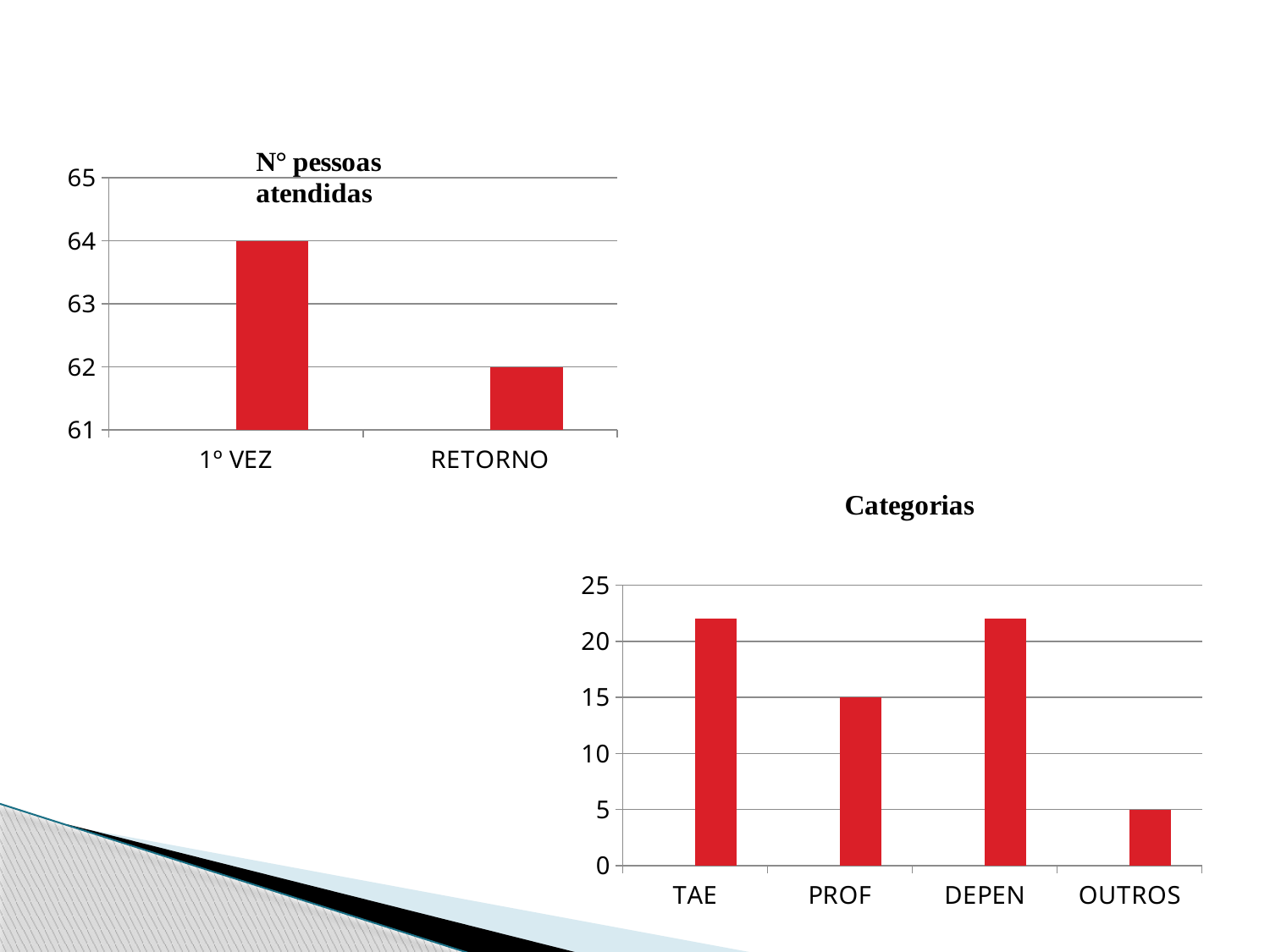
In the 'Categorias' chart, which category has the lowest value? OUTROS In the 'Categorias' chart, which is larger, the value for DEPEN or the value for PROF? DEPEN In the 'Nº pessoas atendidas' chart, what is the value for 1º VEZ? 64 In the 'Categorias' chart, how many categories are shown on the x axis? 4 In the 'Nº pessoas atendidas' chart, which category has the higher value? 1º VEZ In the 'Nº pessoas atendidas' chart, how many categories are shown on the x axis? 2 In the 'Categorias' chart, is the value for TAE greater or less than 20? greater What kind of chart is the 'Categorias' chart? bar chart In the 'Categorias' chart, what is the value for OUTROS? 5 In the 'Categorias' chart, what is the value for PROF? 15 In the 'Nº pessoas atendidas' chart, what is the value for RETORNO? 62 In the 'Nº pessoas atendidas' chart, what is the difference between the values for 1º VEZ and RETORNO? 2